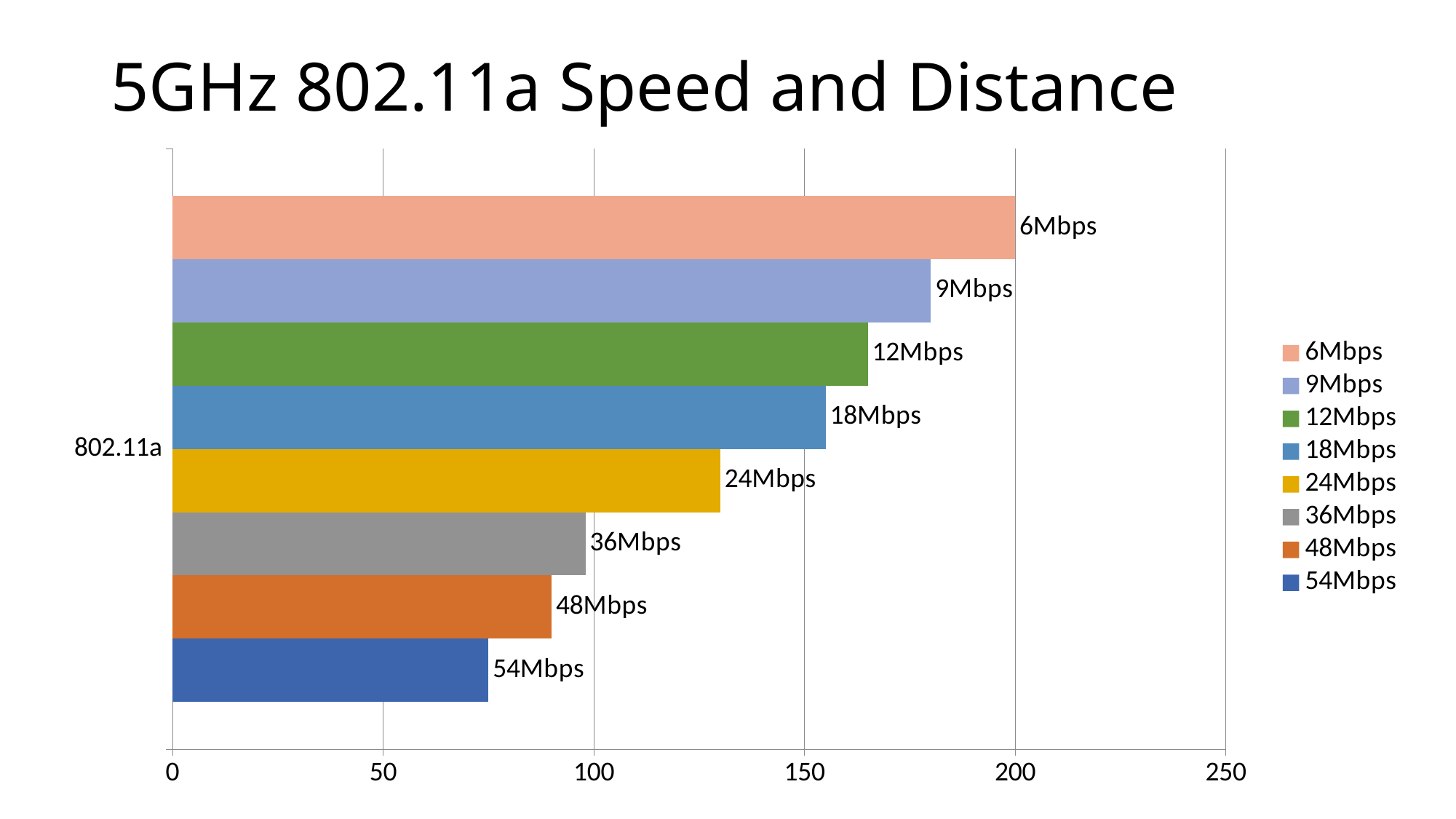
What is the value for the 6Mbps series? 200 What is the title of the chart? 5GHz 802.11a Speed and Distance Is the value for 24Mbps greater or less than 150? less How many series does the legend list? 8 Which is larger, the value for 12Mbps or the value for 48Mbps? 12Mbps Which series has the lowest value? 54Mbps Which series has the highest value? 6Mbps Is the value for 9Mbps greater or less than 150? greater What is the category label shown on the vertical axis? 802.11a What type of chart is shown on the slide? bar chart Is the value for 54Mbps greater or less than 50? greater